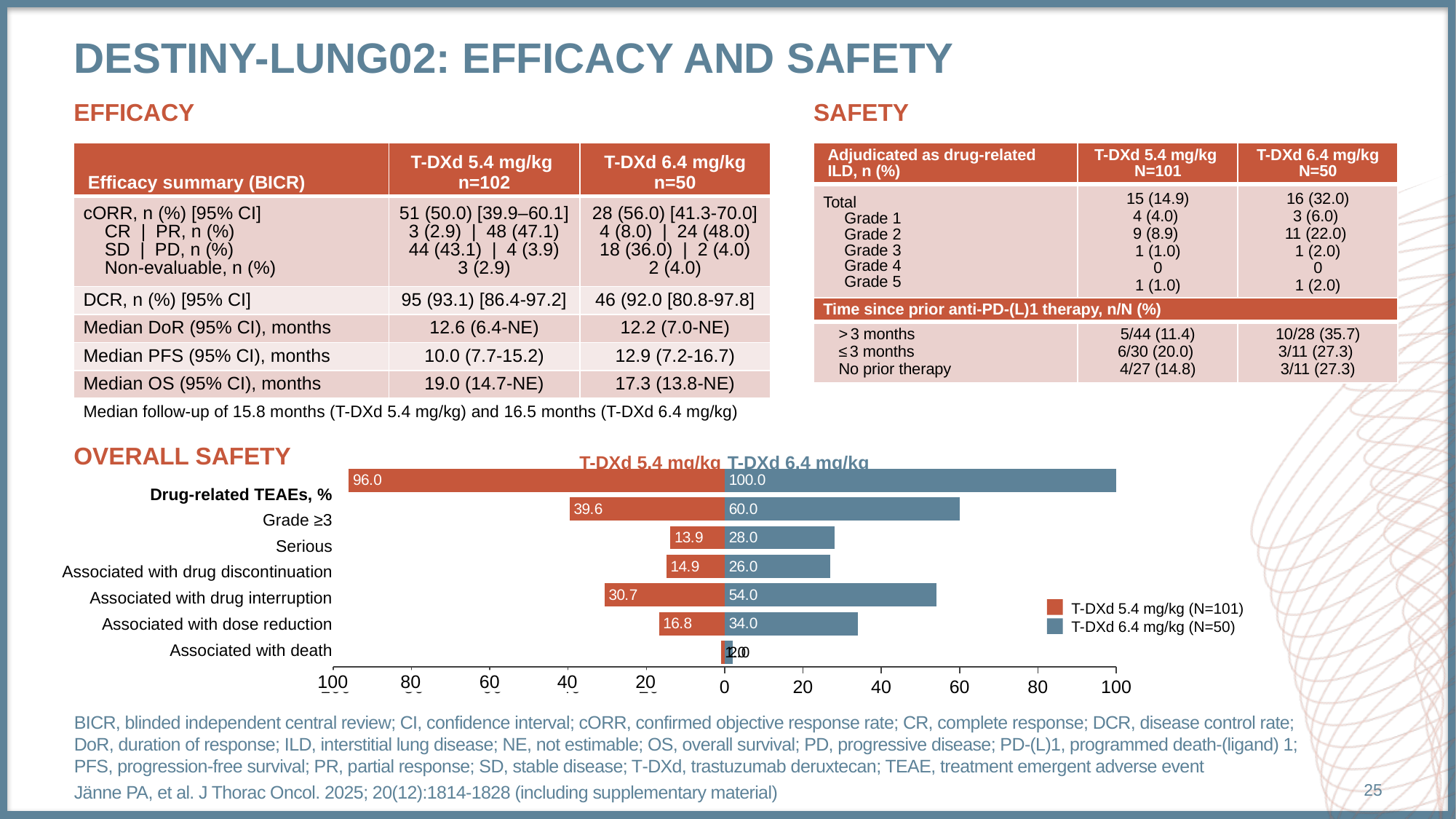
In the OVERALL SAFETY chart, which category has the highest value for T-DXd 6.4 mg/kg? Drug-related TEAEs In the OVERALL SAFETY chart, is the value for Associated with drug discontinuation for T-DXd 6.4 mg/kg greater or less than 20? greater What kind of chart is shown under OVERALL SAFETY? Bar chart In the OVERALL SAFETY chart, what is the value for Associated with drug interruption for T-DXd 5.4 mg/kg? 30.7 How many series does the legend of the OVERALL SAFETY chart list? 2 How many categories are shown in the OVERALL SAFETY chart? 7 In the OVERALL SAFETY chart, which colour represents T-DXd 5.4 mg/kg (N=101)? Orange-red In the OVERALL SAFETY chart, what is the value for Serious for T-DXd 6.4 mg/kg? 28.0 In the OVERALL SAFETY chart, which is larger for Associated with dose reduction: T-DXd 5.4 mg/kg or T-DXd 6.4 mg/kg? T-DXd 6.4 mg/kg In the OVERALL SAFETY chart, what is the difference between the T-DXd 6.4 mg/kg and T-DXd 5.4 mg/kg values for Grade ≥3? 20.4 In the OVERALL SAFETY chart, what is the value for Grade ≥3 for T-DXd 6.4 mg/kg? 60.0 In the OVERALL SAFETY chart, what is the value for Drug-related TEAEs for T-DXd 5.4 mg/kg? 96.0